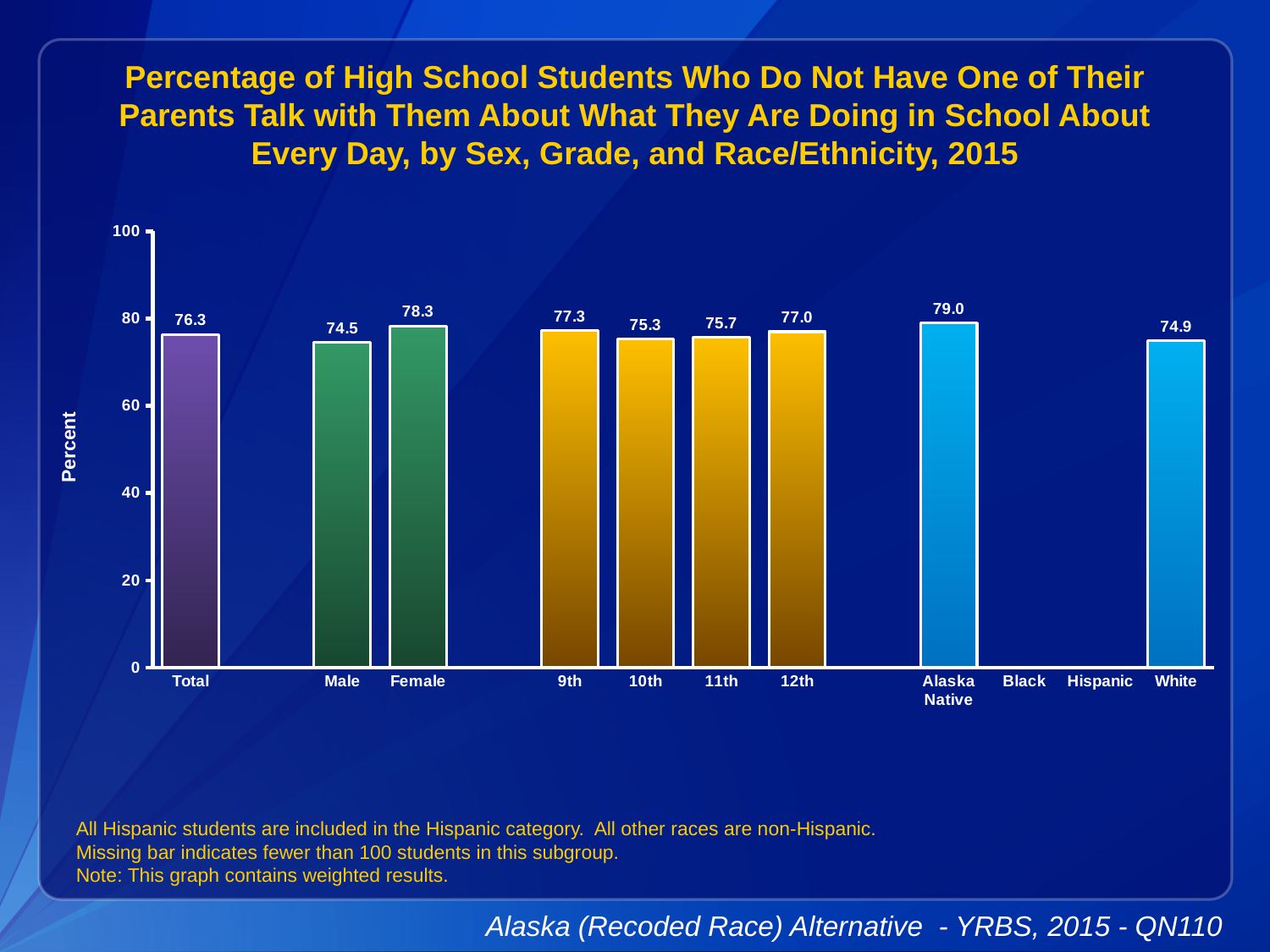
What is the value for Female? 78.3 Which category has the lowest value? Male What is the difference between the Female and Male values? 3.8 What is the value for Total? 76.3 Which category has the highest value? Alaska Native What is the value for Alaska Native? 79.0 Which is larger, the value for 9th grade or the value for 12th grade? 9th What is the label on the y axis? Percent What kind of chart is this? bar chart What is the value for 10th grade? 75.3 Is the value for White greater or less than 80? less How many categories have a bar plotted? 9